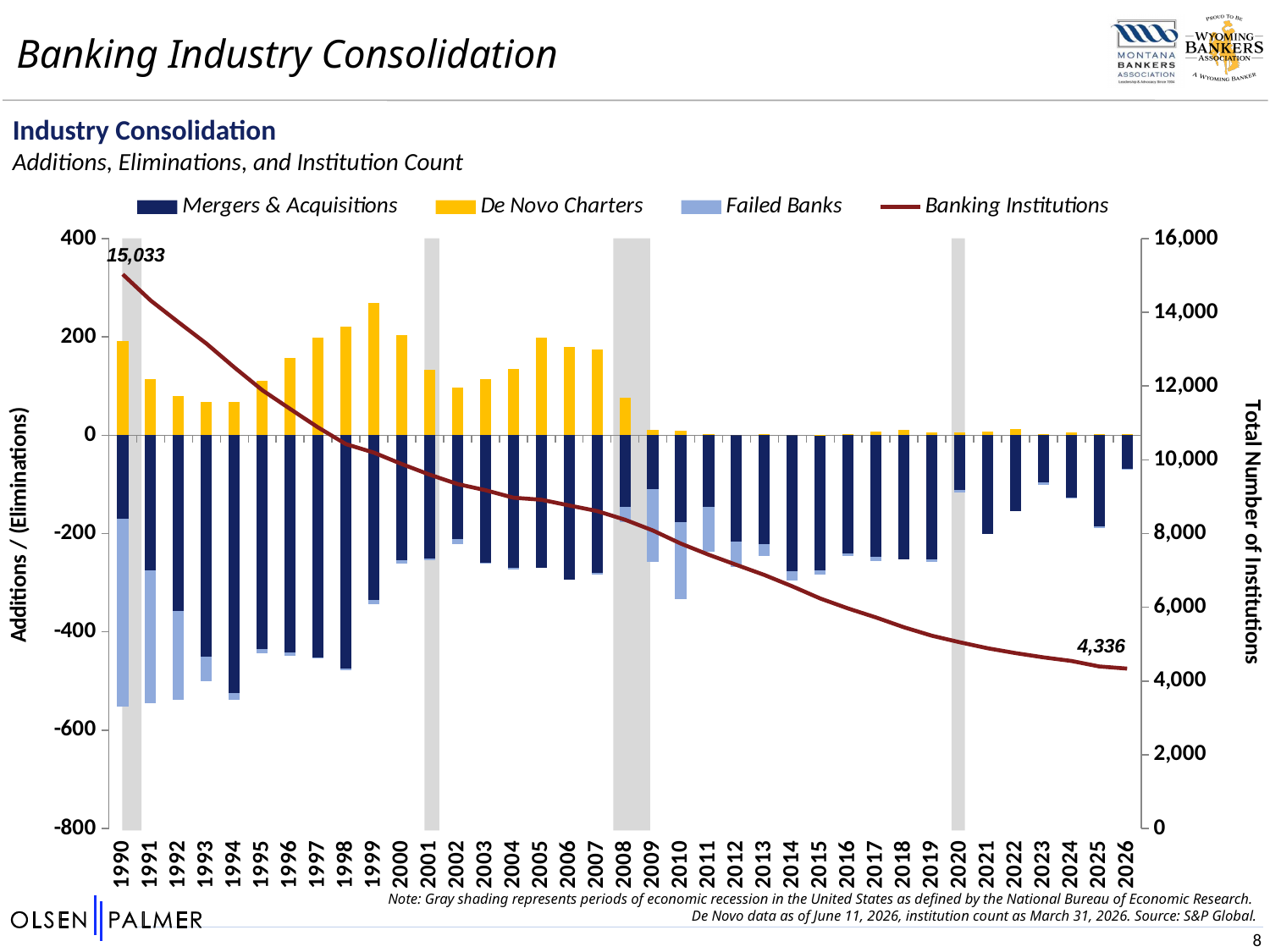
What is the labeled value of Banking Institutions in 1990? 15,033 Does the Banking Institutions line rise or fall from 1990 to 2026? Falls How many series does the legend list? 4 According to the note, what does the gray shading on the chart represent? Periods of economic recession in the United States How many years are shown on the x axis? 37 Is the Banking Institutions value for 2012 greater or less than 8,000? less What is the labeled value of Banking Institutions in 2026? 4,336 What kind of chart is shown on the slide? Combination bar and line chart Which year has the highest De Novo Charters value? 1999 Which year has the higher De Novo Charters value, 1999 or 2002? 1999 By how much did the number of Banking Institutions fall between the 1990 label (15,033) and the 2026 label (4,336)? 10,697 Is the De Novo Charters value for 1999 greater or less than 200? greater